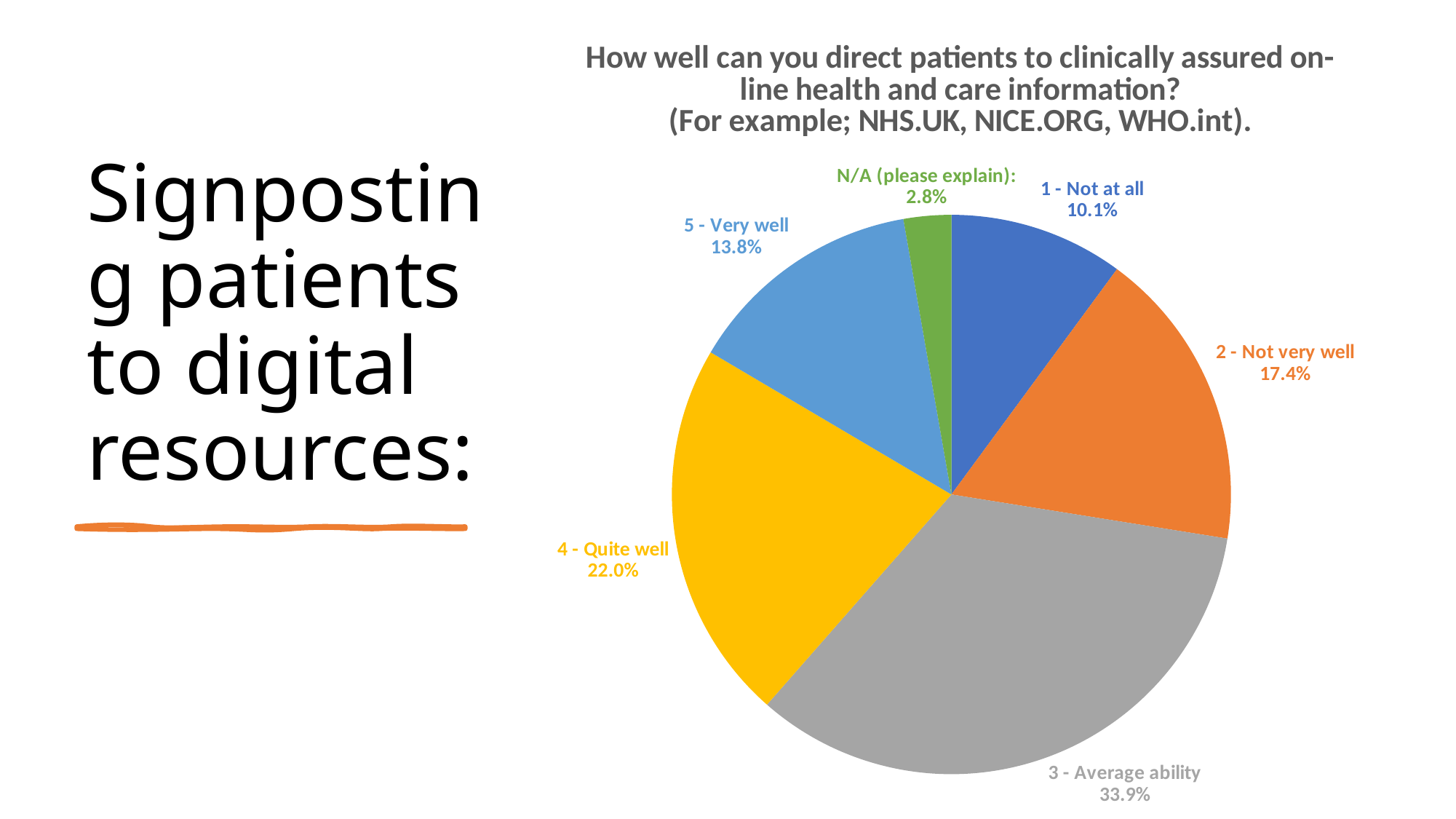
Which is larger: the share for "2 - Not very well" or the share for "5 - Very well"? 2 - Not very well Which response category has the smallest share of the pie? N/A (please explain): What percentage of respondents answered "1 - Not at all"? 10.1% What percentage of respondents answered "N/A (please explain):"? 2.8% What kind of chart is shown on the slide? Pie chart What colour is the slice for "3 - Average ability"? Grey What is the combined percentage of respondents who answered "4 - Quite well" or "5 - Very well"? 35.8% Which response category has the largest share of the pie? 3 - Average ability What percentage of respondents answered "3 - Average ability"? 33.9% What percentage of respondents answered "5 - Very well"? 13.8% How many slices does the pie chart have? 6 What is the difference in percentage points between "4 - Quite well" and "2 - Not very well"? 4.6